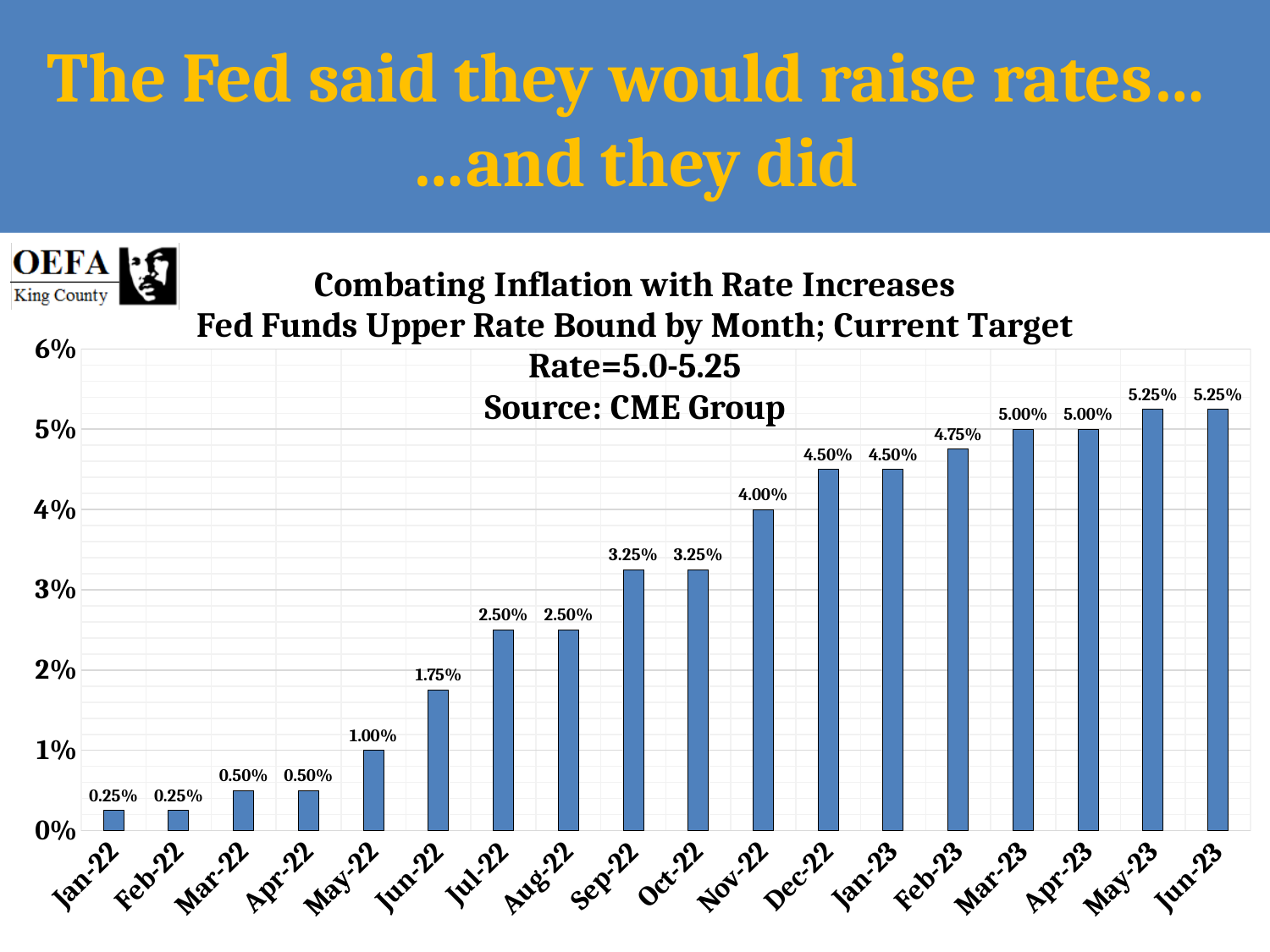
What is the Fed Funds upper rate bound shown for Jan-22? 0.25% Which month has the highest value on the chart? May-23 and Jun-23 (5.25%) What is the value shown for Feb-23? 4.75% What is the value shown for Jun-22? 1.75% Do the values rise or fall from Jan-22 to Jun-23? Rise What is the difference between the values for Sep-22 and Jul-22? 0.75% Which is larger, the value for Dec-22 or the value for Oct-22? Dec-22 What is the value shown for Nov-22? 4.00% What kind of chart is shown on the slide? Bar chart What is the lowest value shown on the chart? 0.25% How many months are shown on the x axis? 18 What is the difference between the values for Jun-23 and Jan-22? 5.00%